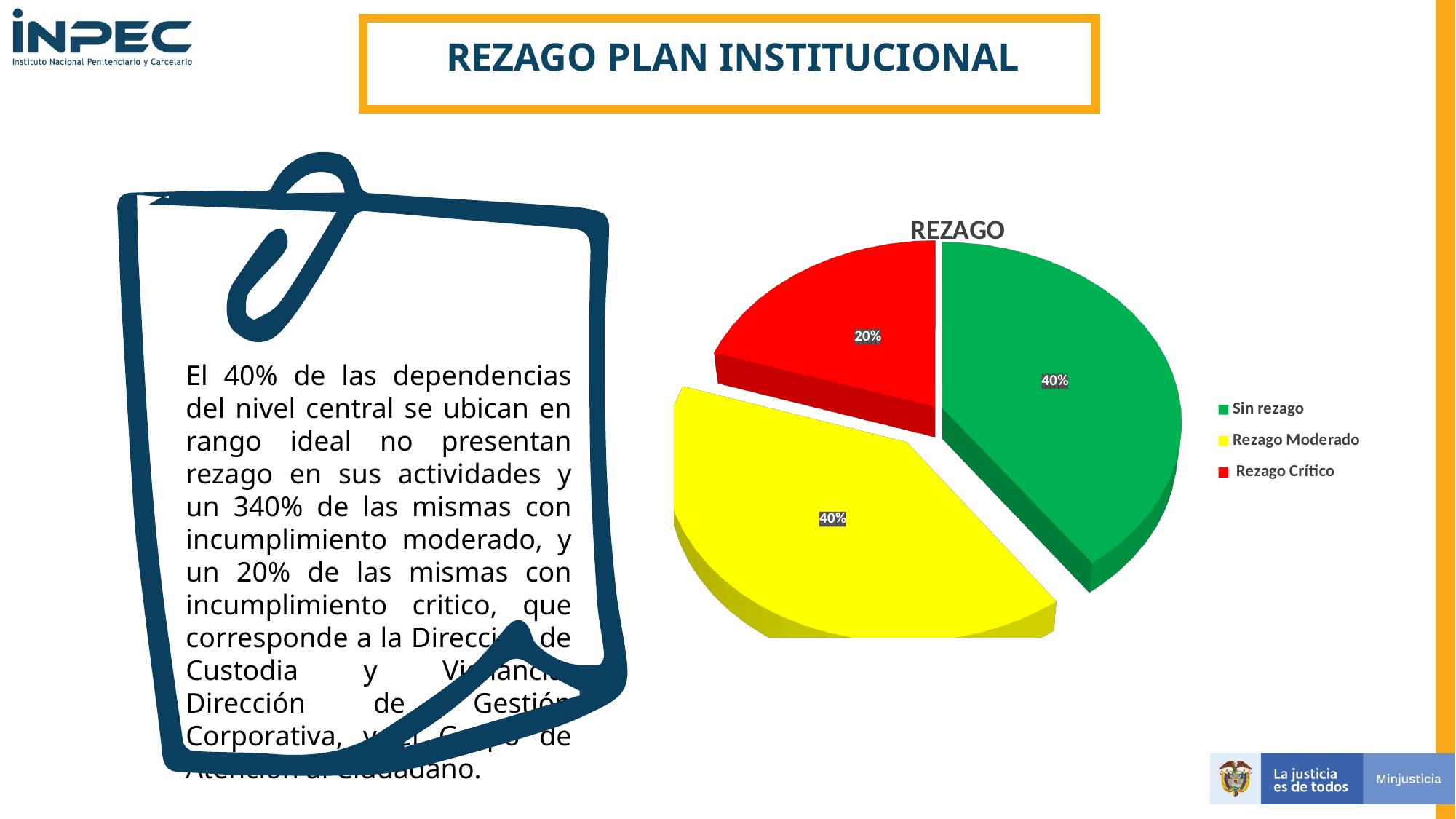
What is the difference between the Rezago Moderado and Rezago Crítico percentages? 20% What percentage does the pie chart show for Sin rezago? 40% How many entries does the chart legend list? 3 What percentage does the pie chart show for Rezago Moderado? 40% What percentage does the pie chart show for Rezago Crítico? 20% What share of the pie does Rezago Crítico represent? 20% Which category has the smallest slice in the pie chart? Rezago Crítico What is the title of the chart? REZAGO What colour is the Rezago Moderado slice? Yellow What type of chart is shown on the slide? Pie chart Which is larger in the pie chart, Sin rezago or Rezago Crítico? Sin rezago How many slices does the pie chart have? 3